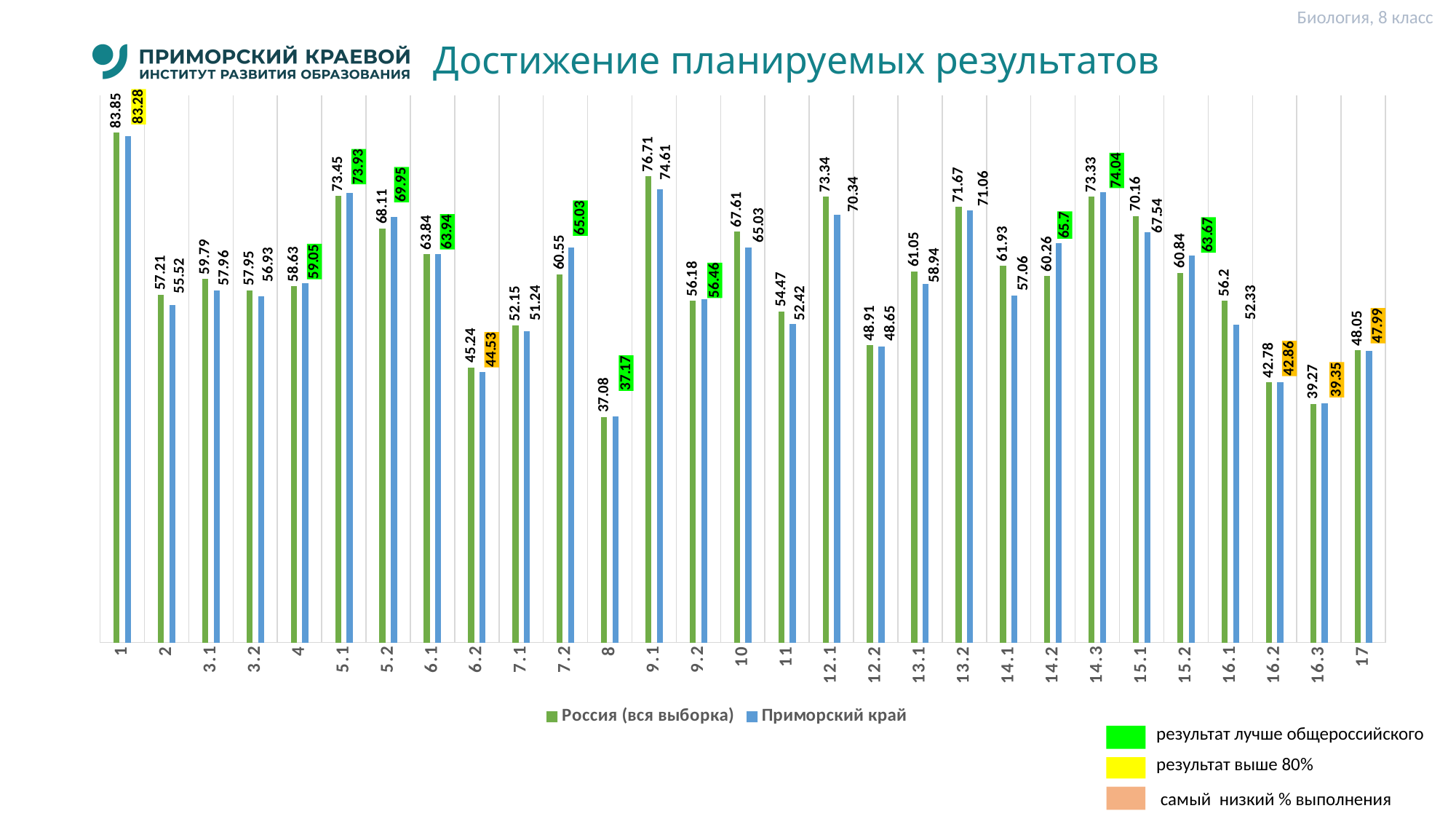
Which task has the highest value for Приморский край? 1 What is the difference between the Приморский край and Россия (вся выборка) values for task 14.2? 5.44 For task 14.1, which series has the larger value: Россия (вся выборка) or Приморский край? Россия (вся выборка) What is the difference between the Россия (вся выборка) and Приморский край values for task 12.1? 3 How many series does the chart legend list? 2 What is the value for Россия (вся выборка) for task 16.3? 39.27 Which task has the lowest value for Россия (вся выборка)? 8 What is the value for Приморский край for task 14.3? 74.04 How many task categories are shown on the x axis? 29 What is the value for Россия (вся выборка) for task 9.1? 76.71 What is the value for Приморский край for task 1? 83.28 What kind of chart is shown on the slide? Bar chart